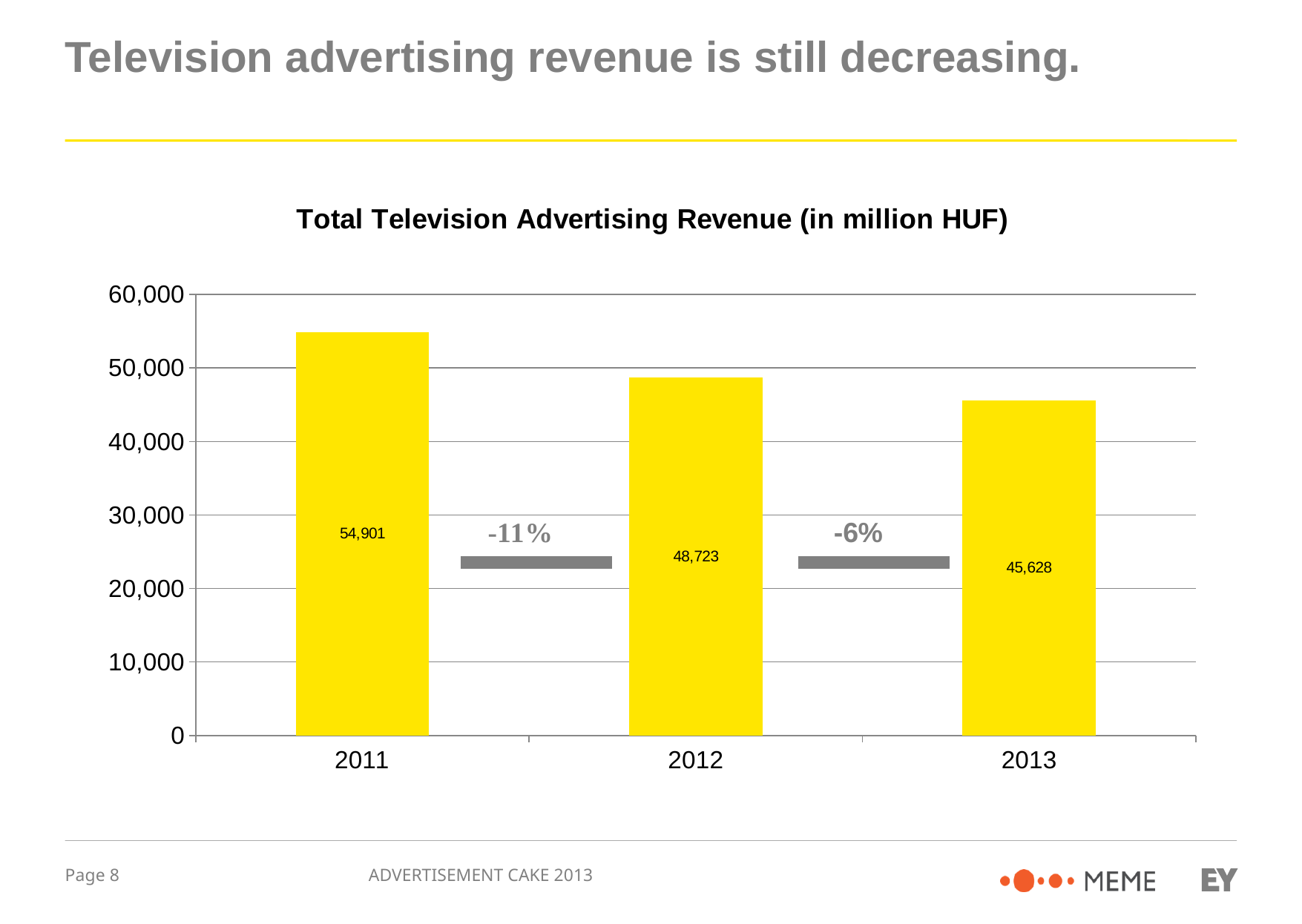
Which year had the lowest television advertising revenue? 2013 Which year had higher television advertising revenue, 2012 or 2013? 2012 What was the total television advertising revenue in 2013? 45,628 Do the values rise or fall from 2011 to 2013? fall What was the total television advertising revenue in 2011? 54,901 Is the value for 2013 greater or less than 50,000? less What was the total television advertising revenue in 2012? 48,723 By how much did television advertising revenue fall from 2012 to 2013? 3,095 By how much did television advertising revenue fall from 2011 to 2012? 6,178 Which year had the highest television advertising revenue? 2011 How many years are shown on the chart? 3 What kind of chart is shown on the slide? bar chart